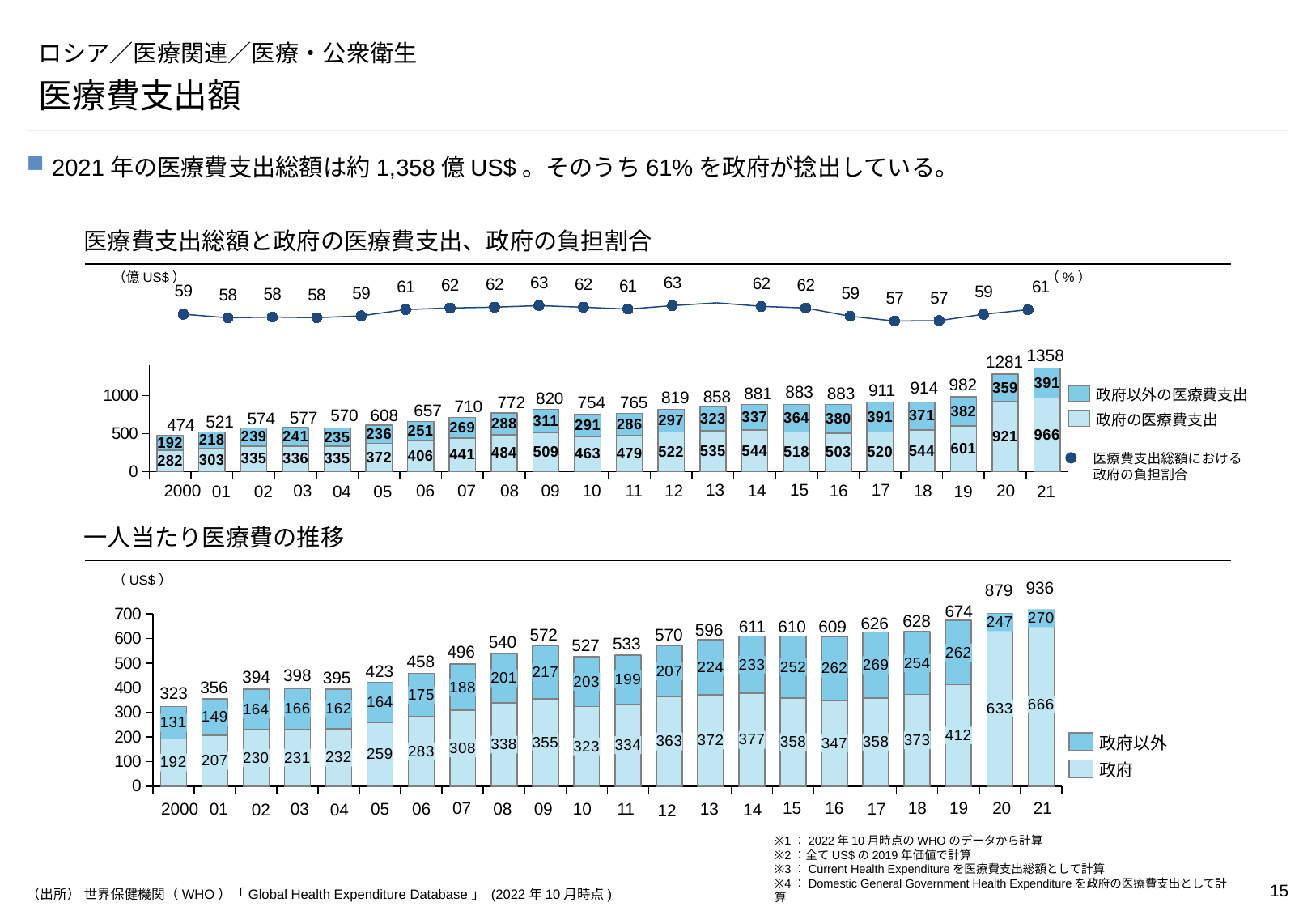
In the top chart, what is the government health expenditure (政府の医療費支出) for 2020? 921 In the top chart, which year has the lowest total health expenditure? 2000 In the bottom chart (一人当たり医療費の推移), what is the total per-capita health expenditure for 2021? 936 In the bottom chart, is the total per-capita value for 2020 larger or smaller than that for 2019? Larger In the bottom chart, what is the government (政府) per-capita value for 2019? 412 In the top chart, what is the government's share of total health expenditure (政府の負担割合) in 2021? 61 In the top chart (医療費支出総額と政府の医療費支出、政府の負担割合), what is the total health expenditure for 2021? 1358 In the bottom chart, what is the non-government (政府以外) per-capita value for 2021? 270 What kind of chart is the bottom chart (一人当たり医療費の推移)? Stacked bar chart How many series does the legend of the top chart list? 3 In the top chart, which year has the highest total health expenditure? 21 In the top chart, what is the difference between the total health expenditure in 2021 and in 2020? 77